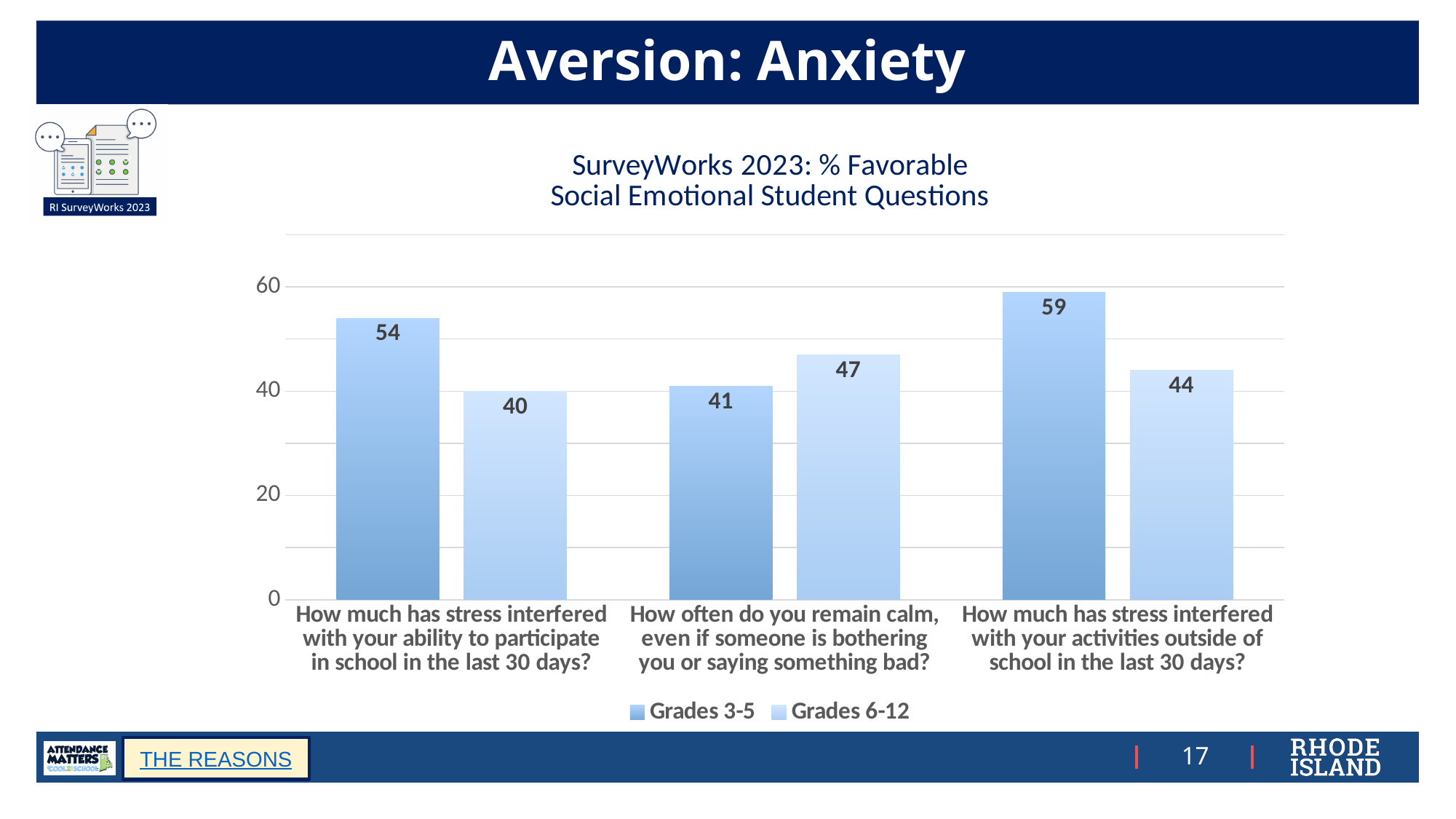
Which question has the lowest Grades 6-12 value? How much has stress interfered with your ability to participate in school in the last 30 days? What is the Grades 6-12 value for "How much has stress interfered with your activities outside of school in the last 30 days?" 44 What is the title of the chart? SurveyWorks 2023: % Favorable Social Emotional Student Questions What kind of chart is shown on the slide? bar chart For "How often do you remain calm, even if someone is bothering you or saying something bad?", which group has the larger value, Grades 3-5 or Grades 6-12? Grades 6-12 Is the Grades 3-5 value for "How often do you remain calm, even if someone is bothering you or saying something bad?" greater or less than 60? less How many series does the legend list? 2 What is the Grades 6-12 value for "How often do you remain calm, even if someone is bothering you or saying something bad?" 47 How many survey questions are shown on the x axis? 3 What is the Grades 3-5 value for "How much has stress interfered with your ability to participate in school in the last 30 days?" 54 What is the difference between the Grades 3-5 and Grades 6-12 values for "How much has stress interfered with your activities outside of school in the last 30 days?" 15 Which question has the highest Grades 3-5 value? How much has stress interfered with your activities outside of school in the last 30 days?